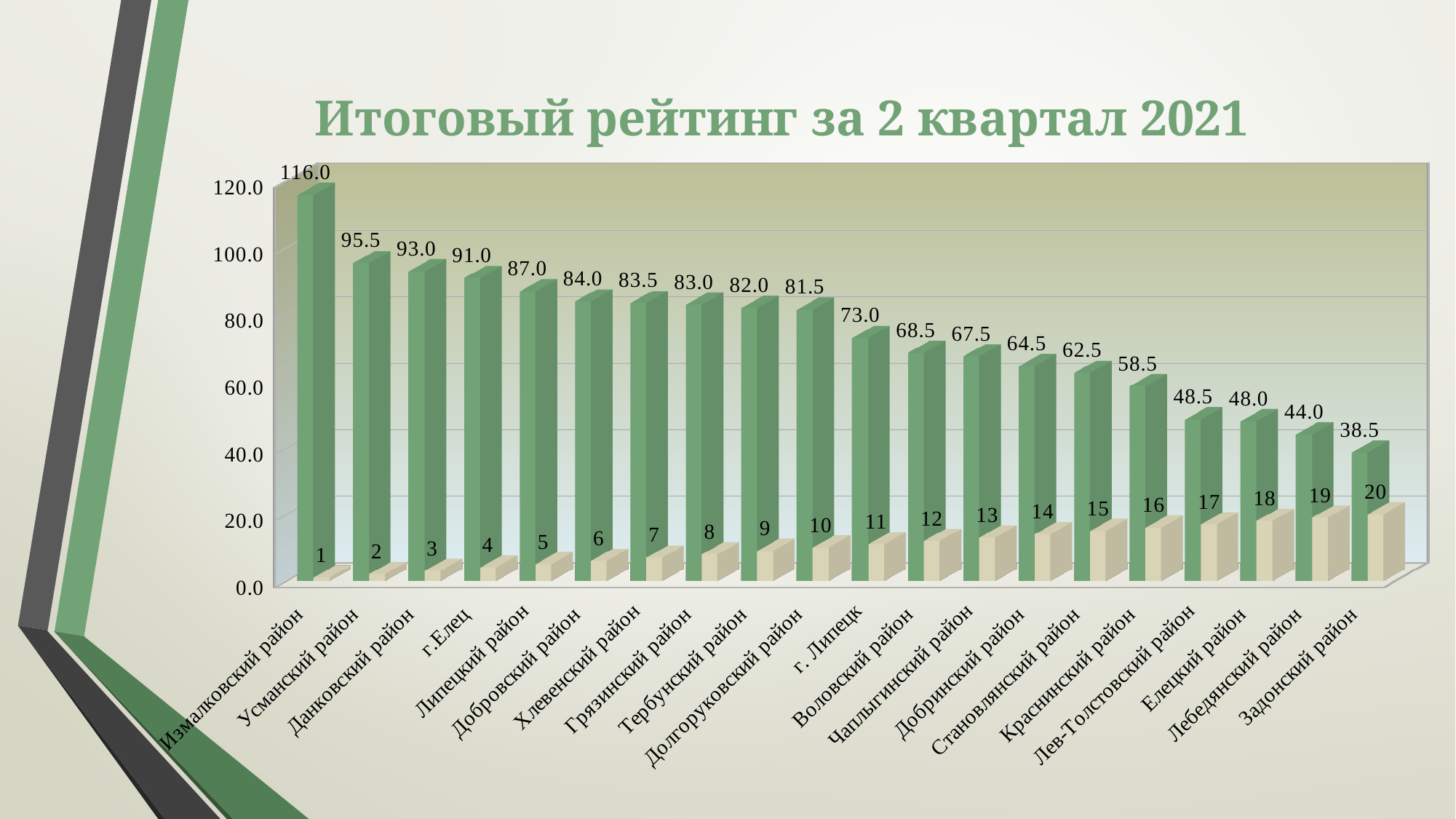
What rank number is shown for Краснинский район? 16 What is the title of the chart? Итоговый рейтинг за 2 квартал 2021 What is the rating value shown for Измалковский район? 116.0 What is the difference between the rating values of Усманский район and Данковский район? 2.5 What is the rating value shown for Задонский район? 38.5 Do the rating values rise or fall from left to right along the x axis? Fall Which district has the highest rating value? Измалковский район How many districts are shown on the x axis? 20 What is the rating value shown for г. Липецк? 73.0 Which has a higher rating value, Воловский район or Добринский район? Воловский район Which district has the lowest rating value? Задонский район What kind of chart is shown on the slide? Bar chart